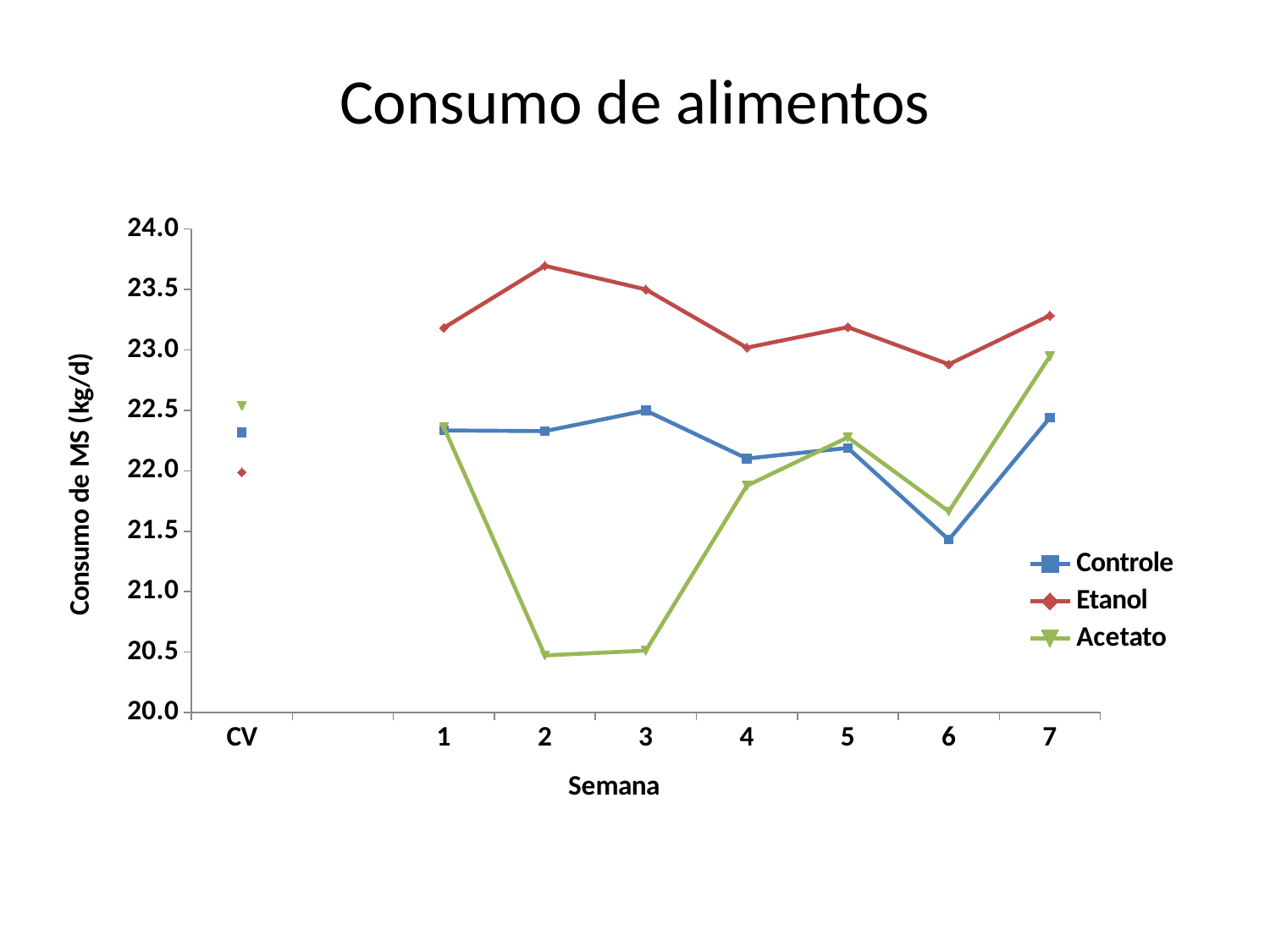
Is the value for Acetato at week 2 greater or less than 21.0? less Which series has the larger value at week 7, Acetato or Controle? Acetato At which week does the Etanol series reach its highest value? 2 What kind of chart is shown on the slide? line chart How many series does the legend list? 3 Does the Acetato series rise or fall from week 3 to week 7? rise What is the title of the y axis? Consumo de MS (kg/d) How many categories are shown on the x axis? 8 Which series has the larger value at week 1, Etanol or Controle? Etanol Is the value for Etanol at week 2 greater or less than 23.5? greater At which week does the Controle series reach its lowest value? 6 Is the value for Etanol at week 6 greater or less than 23.0? less